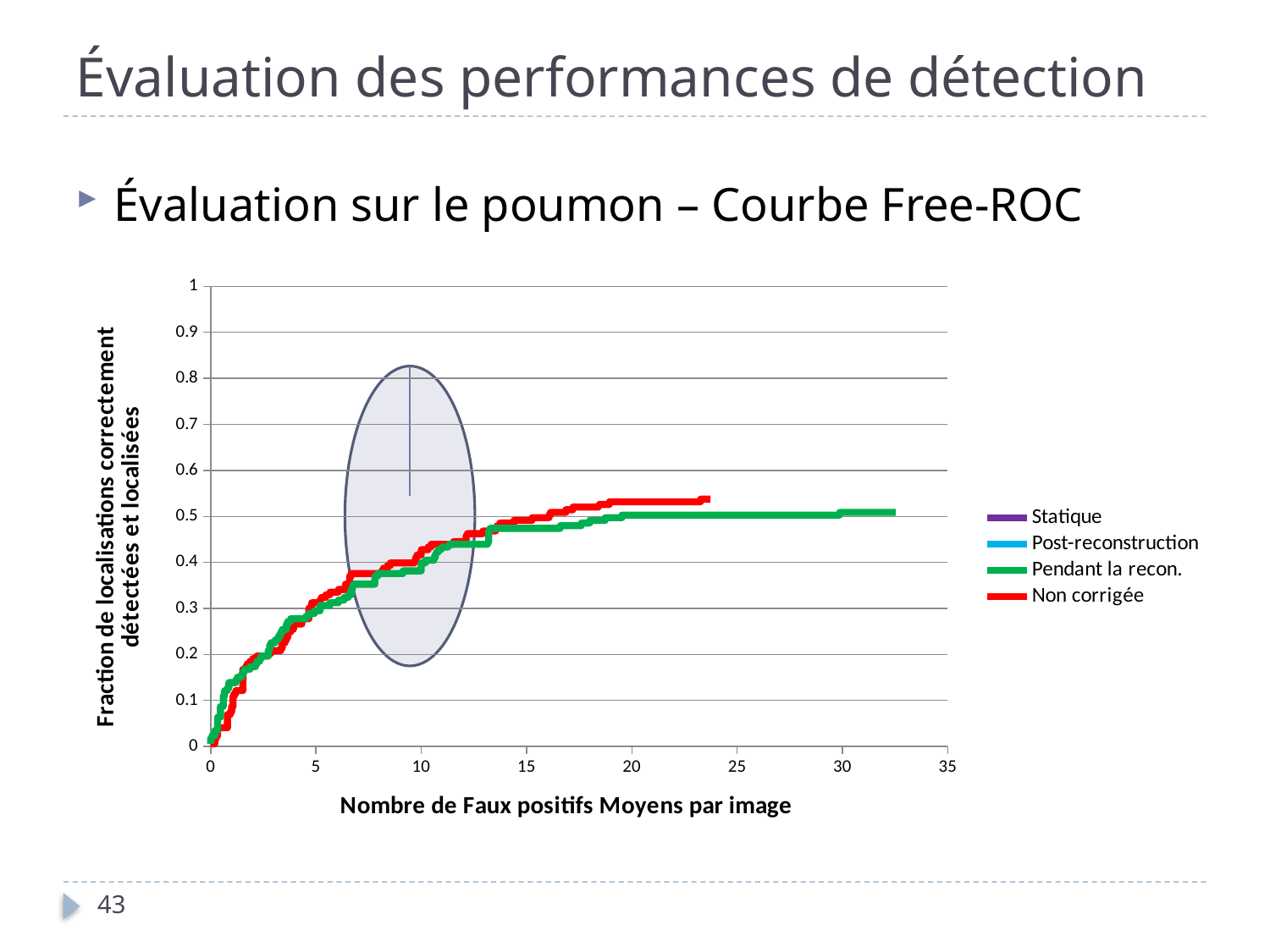
Is the value for 'Non corrigée' at 10 false positives per image greater or less than 0.3? greater Is the value for 'Non corrigée' at 20 false positives per image greater or less than 0.5? greater Is the value for 'Pendant la recon.' at 30 false positives per image greater or less than 0.6? less What kind of chart is shown on the slide? line chart Which series extends furthest along the x axis, 'Non corrigée' or 'Pendant la recon.'? Pendant la recon. What is the title of the x axis? Nombre de Faux positifs Moyens par image How many series does the legend list? 4 Do the values of the 'Pendant la recon.' series rise or fall as the number of false positives per image increases? rise What colour is the line for the series 'Non corrigée'? red What is the highest tick value shown on the x axis? 35 What is the highest tick value shown on the y axis? 1